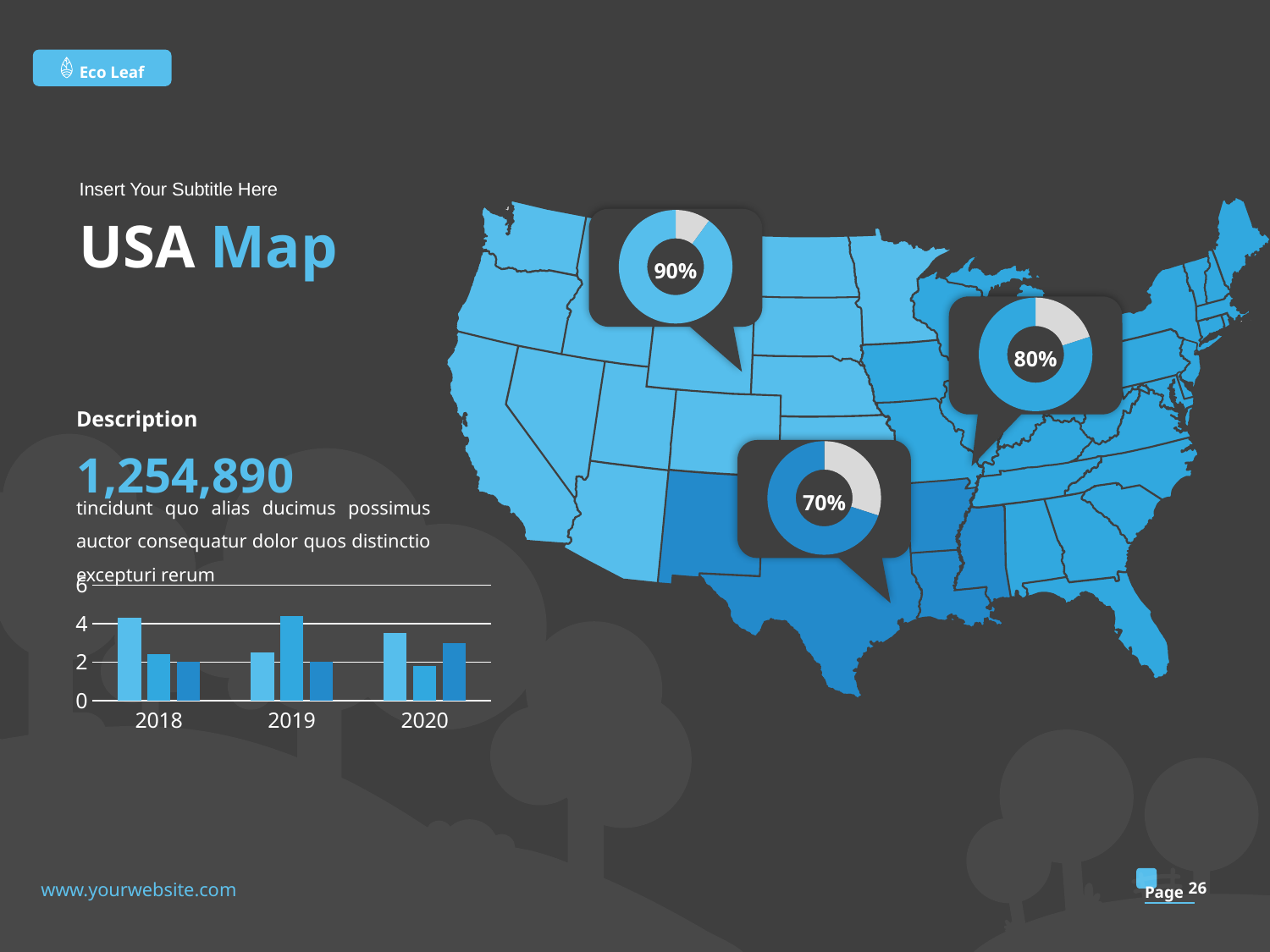
How many years are shown on the x axis of the bar chart at the bottom left? 3 What is the highest value shown on the y axis of the bar chart at the bottom left? 6 In the bar chart at the bottom left, is the value of the first (leftmost) bar for 2019 greater or less than 4? less What kind of chart is shown at the bottom left of the slide, below the description text? bar chart Of the three donut charts on the USA map, which shows the lowest percentage? 70% In the bar chart at the bottom left, is the value of the first (leftmost) bar for 2020 greater or less than 4? less In the bar chart at the bottom left, which bar is tallest within the 2018 group: the first, second or third? first What percentage is shown in the donut chart on the right side of the USA map? 80% In the bar chart at the bottom left, is the value of the middle bar for 2019 greater or less than 4? greater What percentage is shown in the donut chart at the top left of the USA map? 90% How many bars are plotted in total in the bar chart at the bottom left? 9 In the bar chart at the bottom left, which bar is tallest within the 2019 group: the first, second or third? second